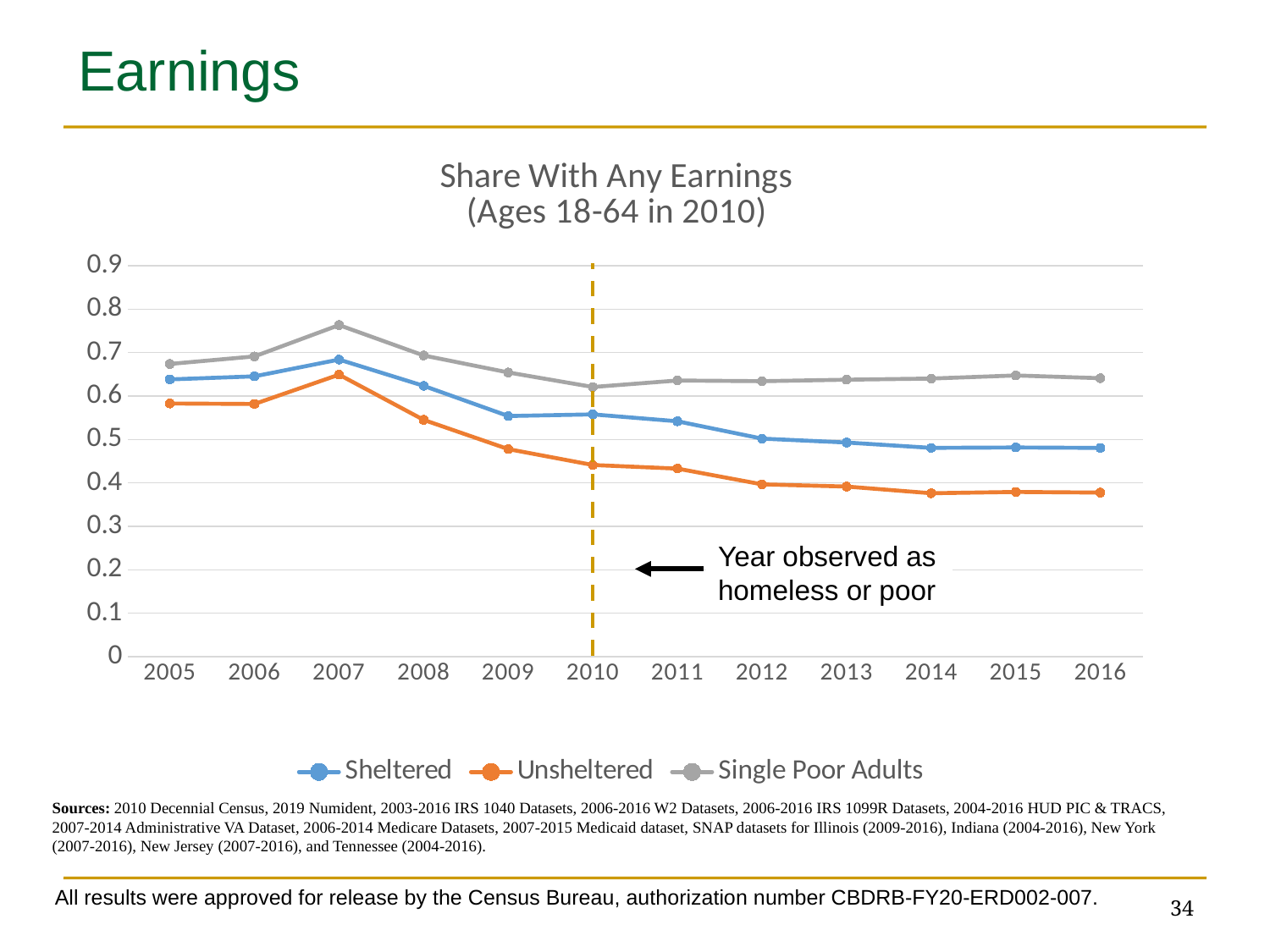
In 2009, which is larger, the Sheltered value or the Unsheltered value? Sheltered Which year is marked by the dashed vertical line labelled as the year observed as homeless or poor? 2010 How many years are plotted along the x axis? 12 Which series has the highest value in 2016? Single Poor Adults Which series has the lowest value in 2010? Unsheltered Is the value for Unsheltered in 2016 greater or less than 0.4? less In which year does the Single Poor Adults series reach its highest value? 2007 What kind of chart is shown on the slide? Line chart Is the value for Single Poor Adults in 2007 greater or less than 0.7? greater How many series does the legend list? 3 What is the title of the chart? Share With Any Earnings (Ages 18-64 in 2010) Does the Unsheltered series rise or fall from 2010 to 2016? Fall